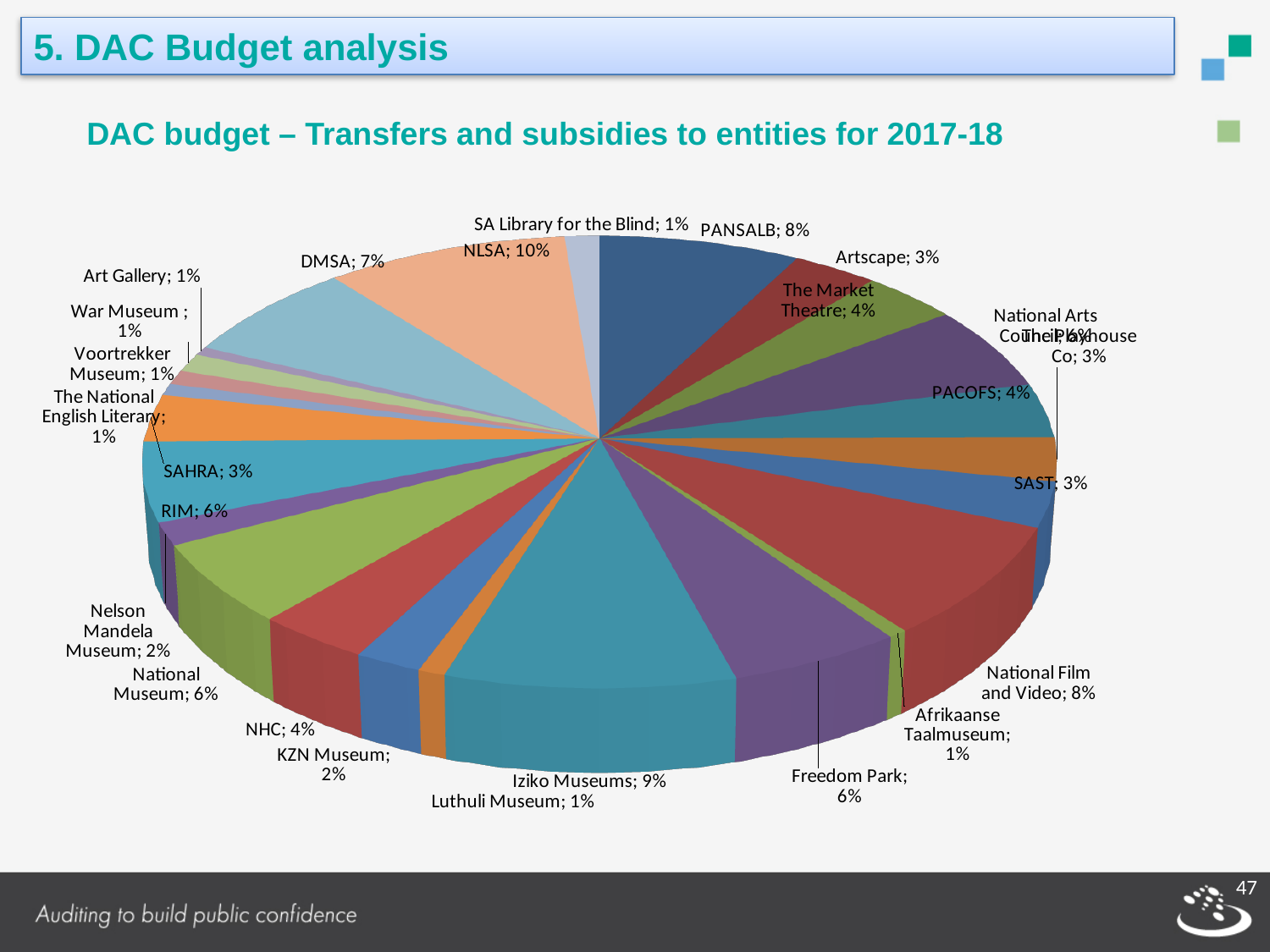
What percentage is shown for PANSALB? 8% What is the difference in percentage points between NLSA and DMSA? 3% What is the difference in percentage points between Iziko Museums and RIM? 3% What share of the DAC budget transfers goes to NLSA? 10% What percentage is shown for National Film and Video? 8% What share of the pie is Iziko Museums? 9% What percentage is shown for PACOFS? 4% Which entity has the largest share of the pie? NLSA Which is larger, the share for Freedom Park or the share for NHC? Freedom Park What type of chart is shown on the slide? Pie chart What percentage is shown for KZN Museum? 2% What is the title of the chart? DAC budget – Transfers and subsidies to entities for 2017-18